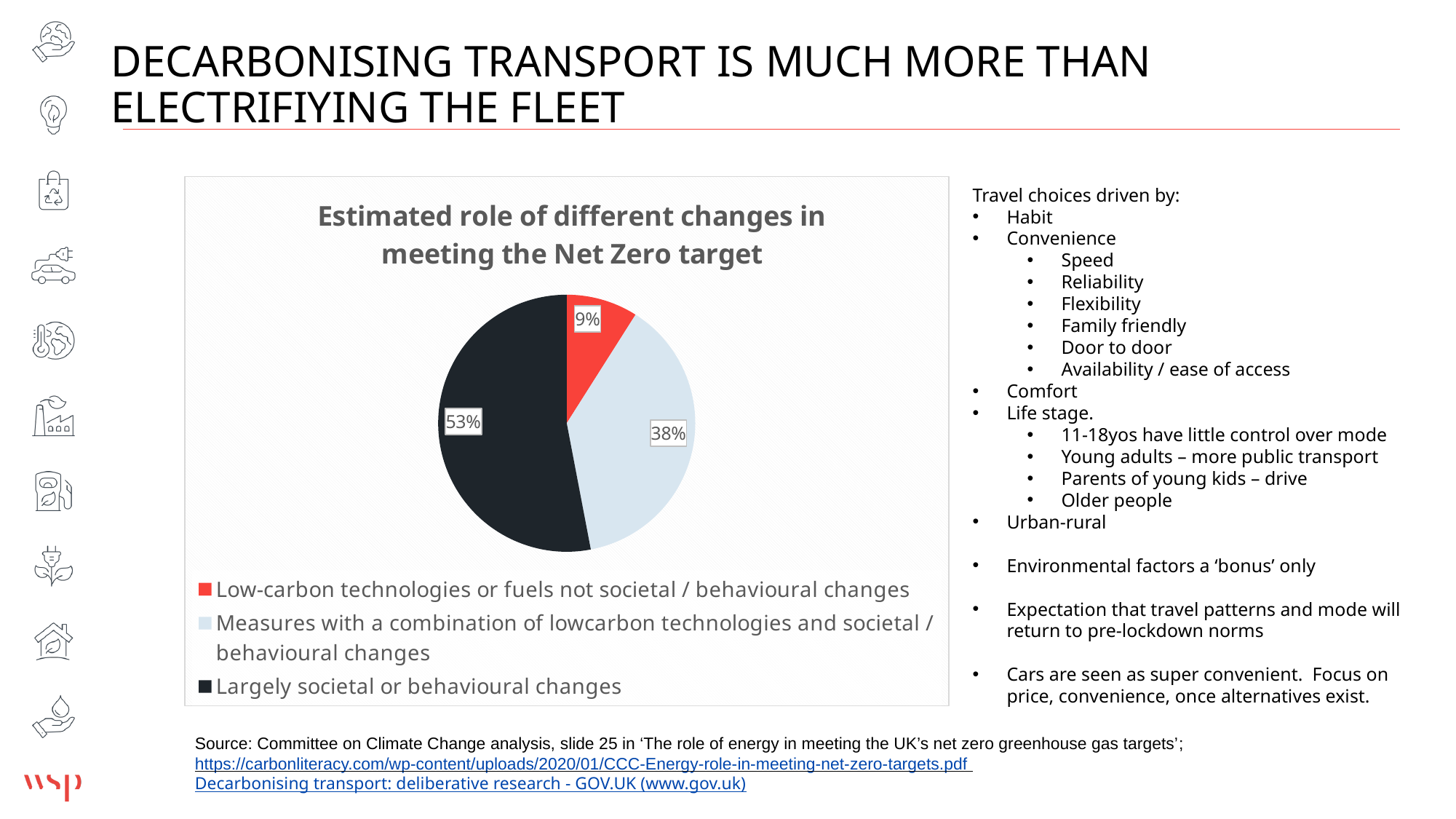
How many slices does the pie chart have? 3 Which category has the largest slice of the pie? Largely societal or behavioural changes What share of the pie is attributed to 'Low-carbon technologies or fuels not societal / behavioural changes'? 9% What is the combined share of the two slices that involve societal or behavioural changes (38% and 53%)? 91% Which category has the smallest slice of the pie? Low-carbon technologies or fuels not societal / behavioural changes What is the difference in percentage points between the 'Largely societal or behavioural changes' slice and the 'Measures with a combination of lowcarbon technologies and societal / behavioural changes' slice? 15 percentage points What colour is the slice representing 'Low-carbon technologies or fuels not societal / behavioural changes'? Red What is the title of the chart? Estimated role of different changes in meeting the Net Zero target What share of the pie is attributed to 'Measures with a combination of lowcarbon technologies and societal / behavioural changes'? 38% Which is larger: the slice for 'Measures with a combination of lowcarbon technologies and societal / behavioural changes' or the slice for 'Low-carbon technologies or fuels not societal / behavioural changes'? Measures with a combination of lowcarbon technologies and societal / behavioural changes What kind of chart is shown on the slide? Pie chart What share of the pie is attributed to 'Largely societal or behavioural changes'? 53%